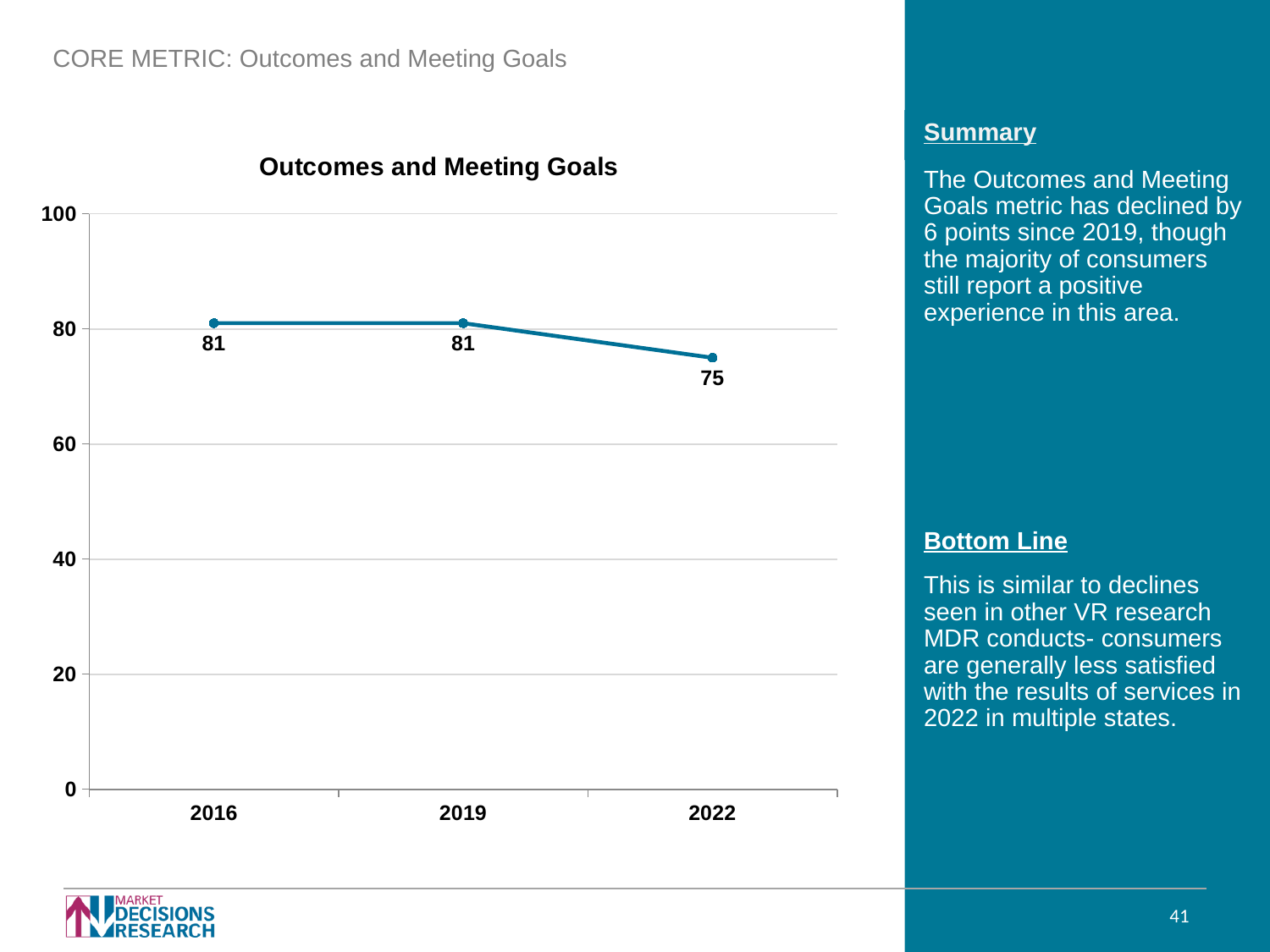
How many years are plotted on the chart? 3 What is the value for 2022? 75 Is the value for 2022 greater or less than 80? less Which is larger, the value for 2016 or the value for 2022? 2016 What is the value for 2019? 81 Is the value for 2016 greater or less than 60? greater What is the value for 2016? 81 Which year has the lowest value? 2022 What is the title of the chart? Outcomes and Meeting Goals What is the difference between the values for 2019 and 2022? 6 What kind of chart is shown? line chart Do the values rise or fall from 2019 to 2022? fall